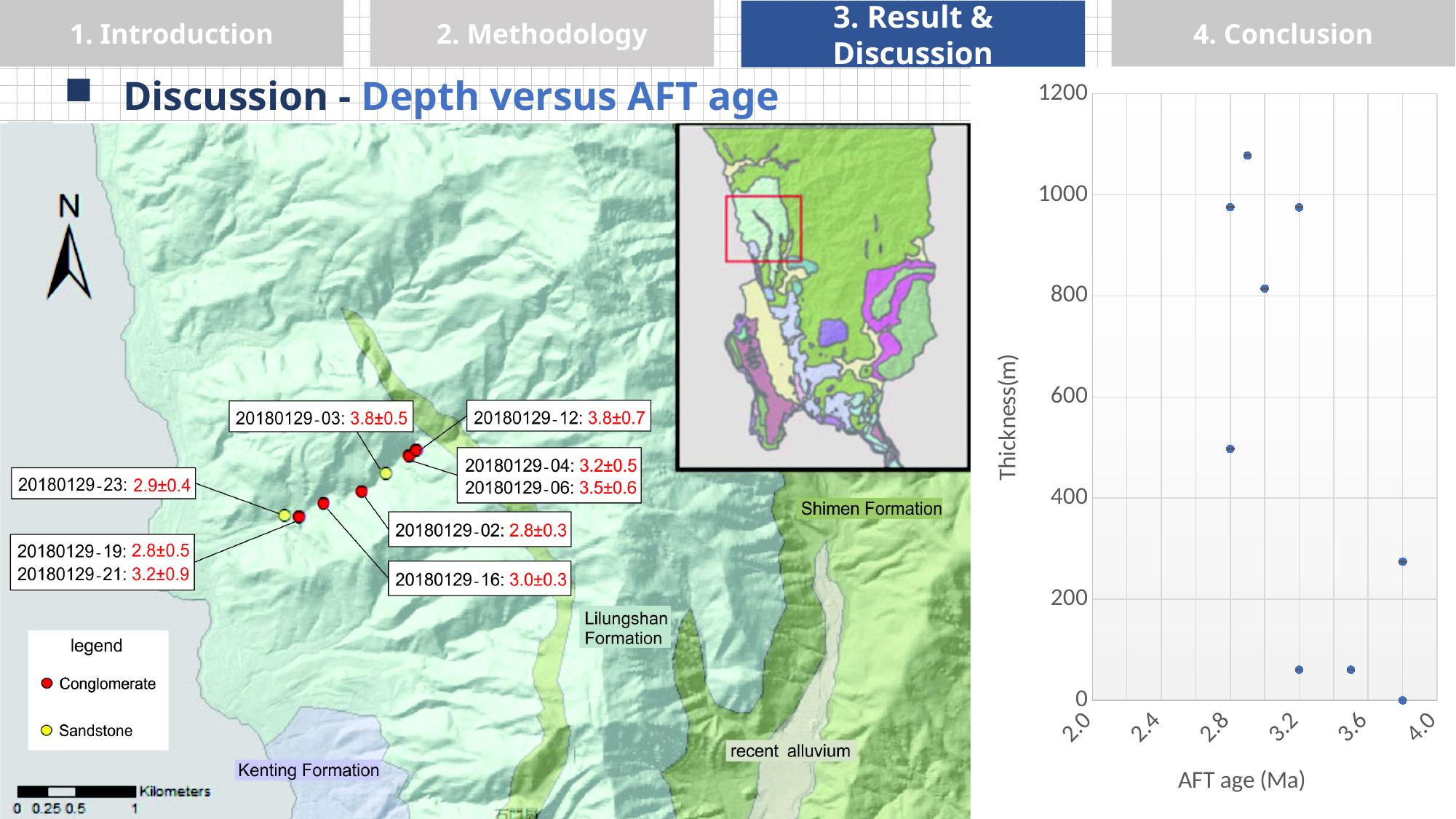
What is the lowest value shown on the horizontal axis of the scatter chart? 2.0 What is the label of the vertical axis of the scatter chart? Thickness(m) In the scatter chart, is the thickness of the point at an AFT age of about 3.8 Ma that lies between the 200 and 400 gridlines greater or less than 200? greater In the scatter chart, is the AFT age of the highest point greater or less than 2.8? greater In the scatter chart, is the thickness of the highest point greater or less than 1000? greater What is the label of the horizontal axis of the scatter chart? AFT age (Ma) How many data points are plotted in the scatter chart? 9 What kind of chart is shown on the right side of the slide? scatter chart What is the highest value shown on the vertical axis of the scatter chart? 1200 What is the highest value shown on the horizontal axis of the scatter chart? 4.0